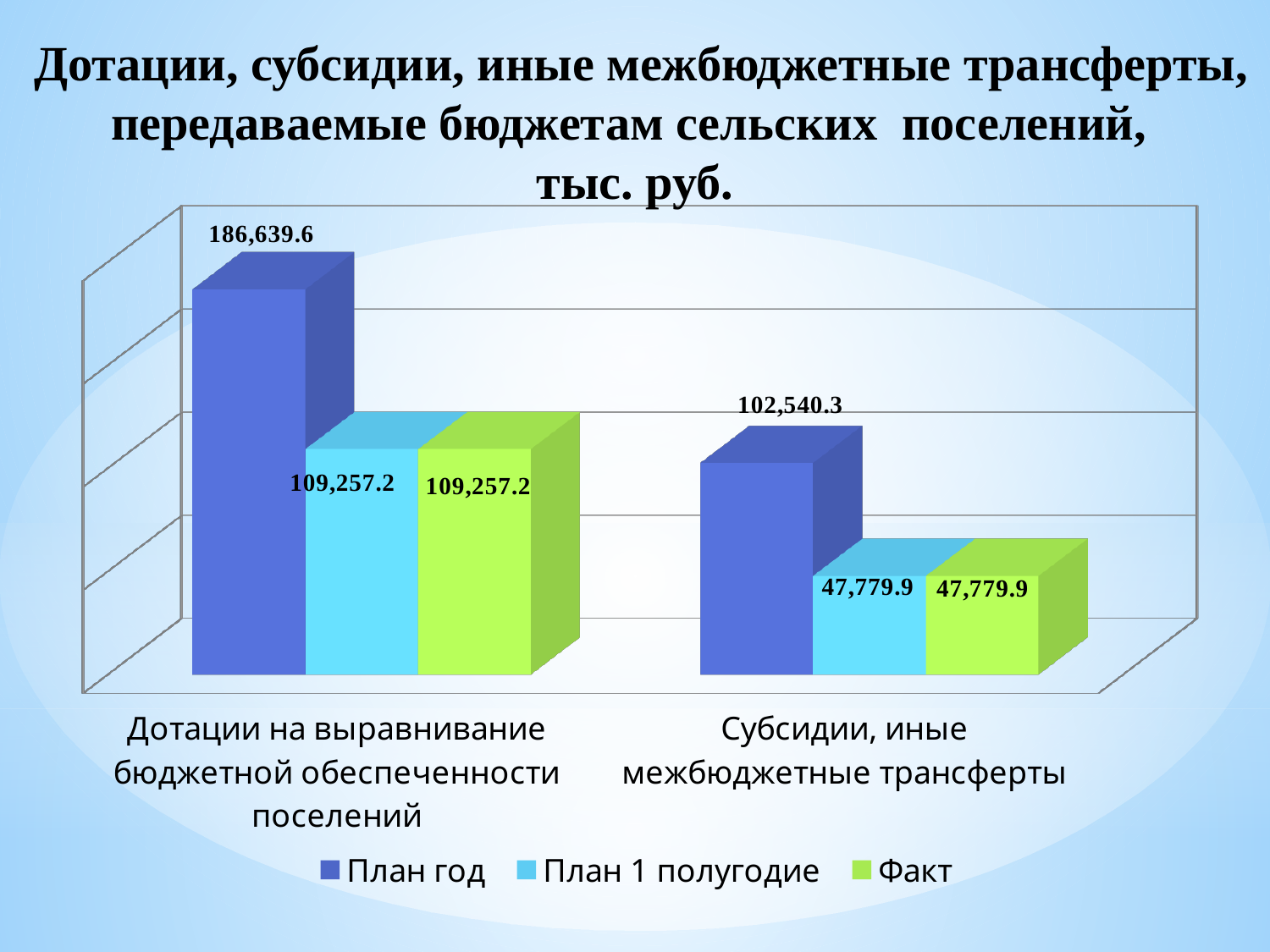
How many categories are shown on the x axis? 2 Which is larger: "Факт" for "Дотации на выравнивание бюджетной обеспеченности поселений" or "План год" for "Субсидии, иные межбюджетные трансферты"? Факт for Дотации на выравнивание бюджетной обеспеченности поселений What is the value of "План год" for "Дотации на выравнивание бюджетной обеспеченности поселений"? 186,639.6 How many series does the legend list? 3 What is the value of "Факт" for "Субсидии, иные межбюджетные трансферты"? 47,779.9 What is the value of "План год" for "Субсидии, иные межбюджетные трансферты"? 102,540.3 What is the value of "План 1 полугодие" for "Дотации на выравнивание бюджетной обеспеченности поселений"? 109,257.2 What kind of chart is shown on the slide? Bar chart Which series has the lowest value for "Субсидии, иные межбюджетные трансферты"? План 1 полугодие and Факт (both 47,779.9) What is the difference between "План год" and "Факт" for "Дотации на выравнивание бюджетной обеспеченности поселений"? 77,382.4 Which category has the highest "План год" value? Дотации на выравнивание бюджетной обеспеченности поселений What is the difference between "План год" and "План 1 полугодие" for "Субсидии, иные межбюджетные трансферты"? 54,760.4